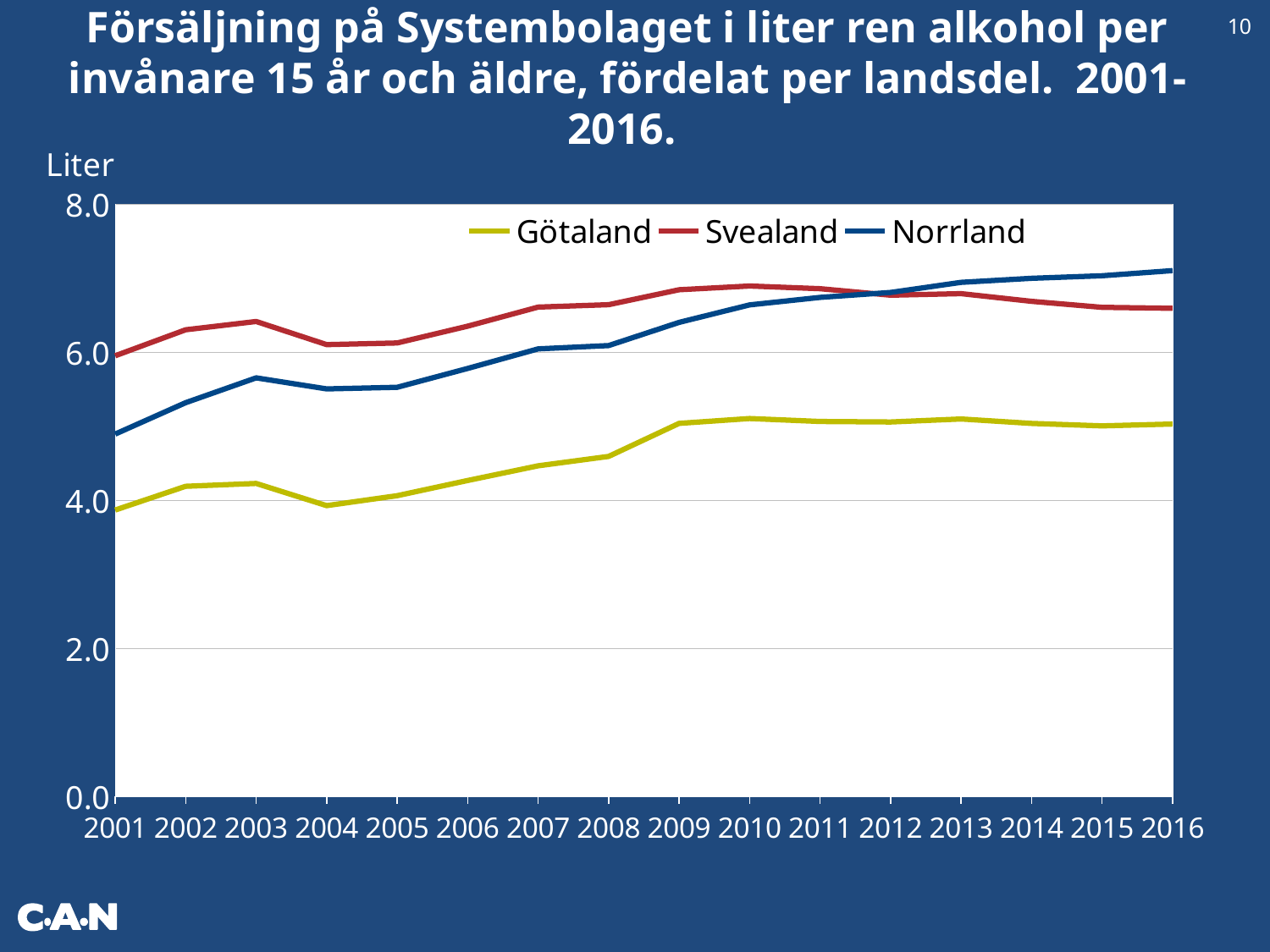
What kind of chart is shown on the slide? line chart Is the value for Norrland in 2016 greater or less than 6.0? greater Which series has the lowest value in 2010? Götaland Is the value for Norrland in 2001 greater or less than 6.0? less In 2001, which is larger: the value for Svealand or the value for Norrland? Svealand Which series has the highest value in 2005? Svealand Which series has the highest value in 2016? Norrland Is the value for Götaland in 2009 greater or less than 4.0? greater How many years are shown along the x axis? 16 How many series does the legend list? 3 Does the value for Norrland generally rise or fall from 2001 to 2016? rise What unit is shown on the y axis label? Liter